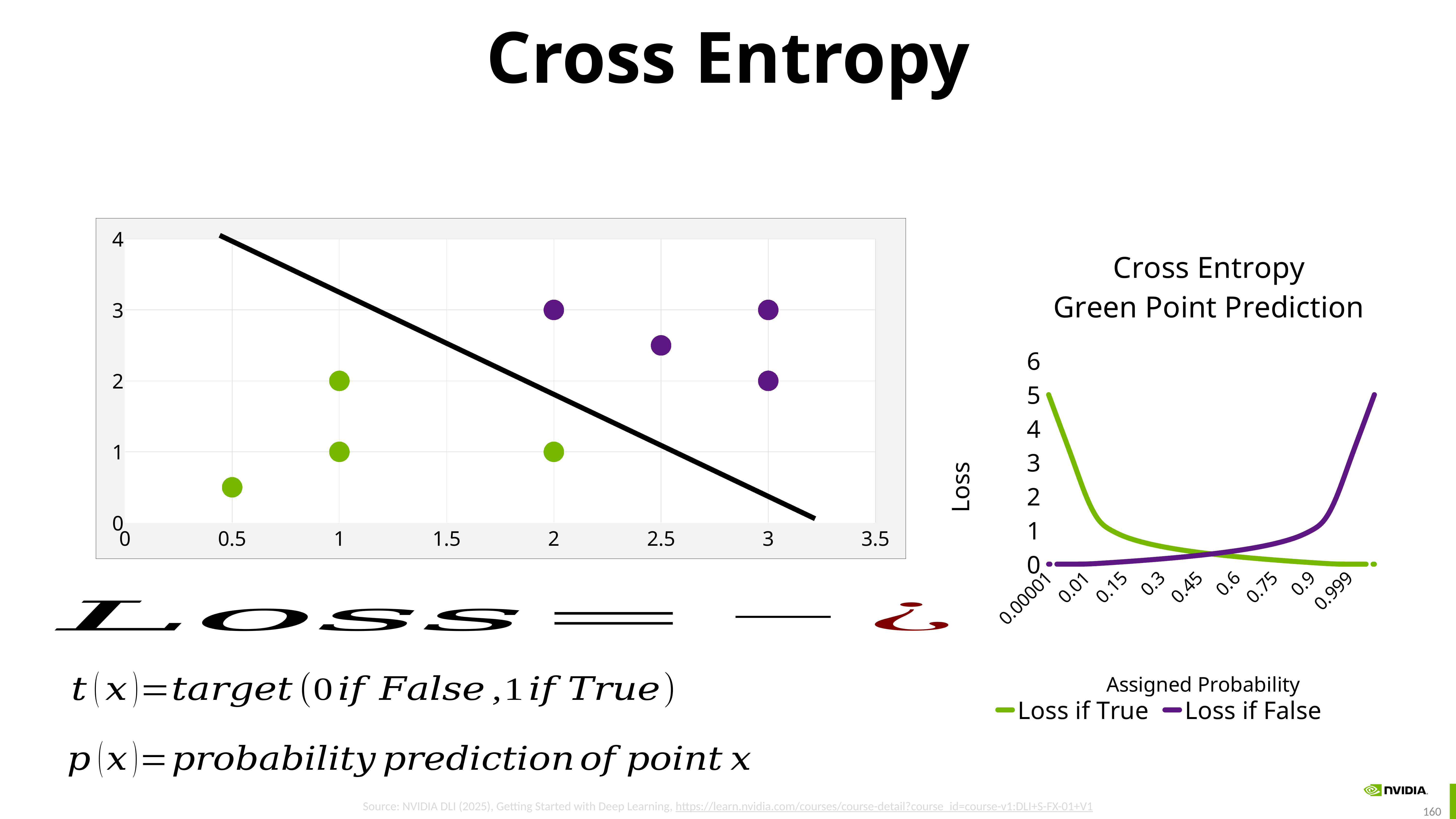
On the left scatter chart, how many purple points are plotted? 4 On the right chart titled 'Cross Entropy Green Point Prediction', does the 'Loss if False' line rise or fall as assigned probability increases? rise On the left scatter chart, how many green points are plotted? 4 On the right chart titled 'Cross Entropy Green Point Prediction', how many series does the legend list? 2 On the right chart titled 'Cross Entropy Green Point Prediction', at an assigned probability of 0.01, which series has the larger loss, 'Loss if True' or 'Loss if False'? Loss if True On the right chart titled 'Cross Entropy Green Point Prediction', what is the label of the y axis? Loss On the right chart titled 'Cross Entropy Green Point Prediction', what kind of chart is it? line chart On the right chart titled 'Cross Entropy Green Point Prediction', is the 'Loss if False' value at 0.01 greater or less than 1? less On the right chart titled 'Cross Entropy Green Point Prediction', does the 'Loss if True' line rise or fall as assigned probability increases? fall On the right chart titled 'Cross Entropy Green Point Prediction', at an assigned probability of 0.9, which series has the larger loss, 'Loss if True' or 'Loss if False'? Loss if False On the right chart titled 'Cross Entropy Green Point Prediction', how many assigned probability values are labelled on the x axis? 9 On the right chart titled 'Cross Entropy Green Point Prediction', is the 'Loss if True' value at 0.00001 greater or less than 4? greater